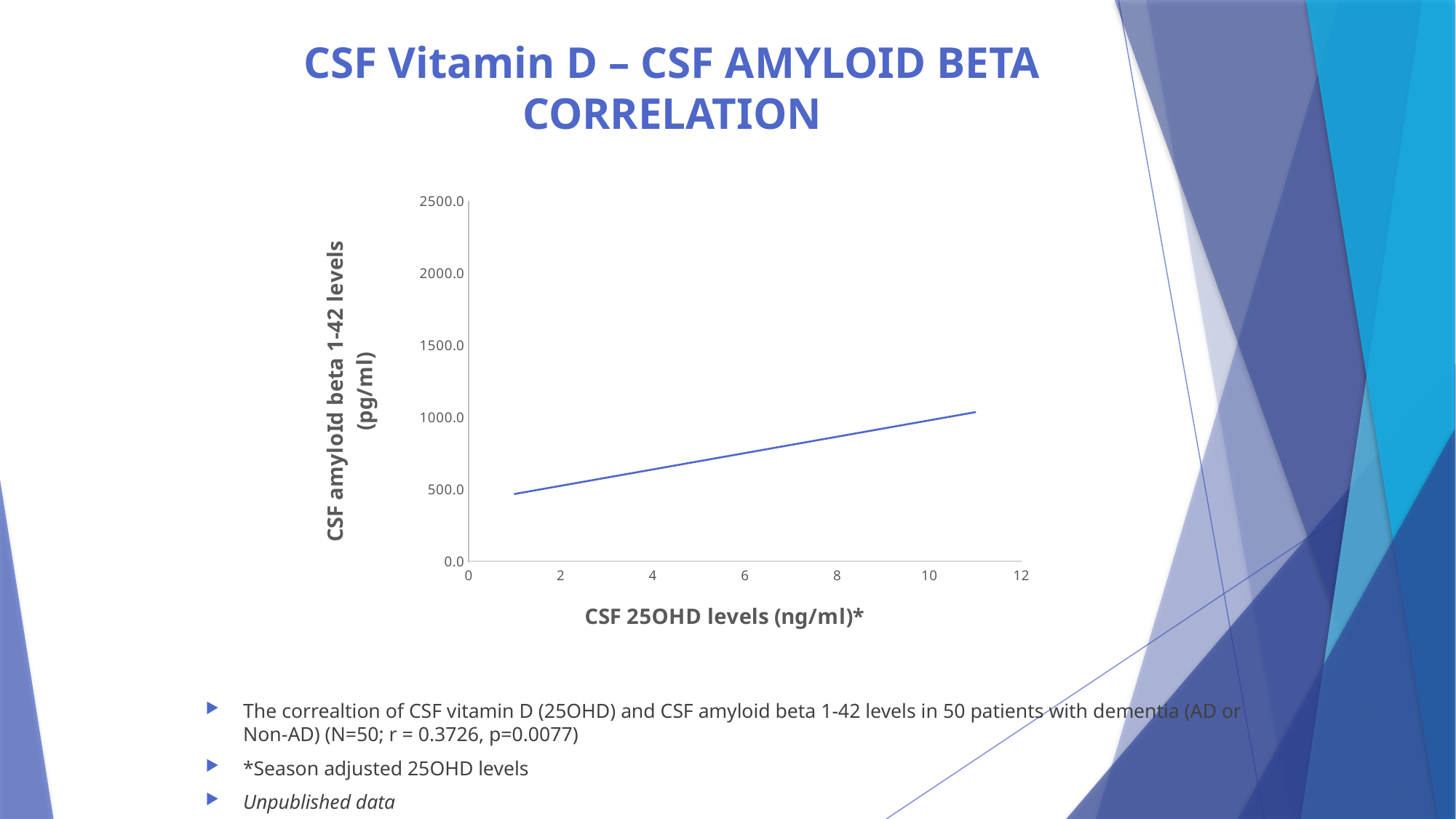
Do the CSF amyloid beta 1-42 levels rise or fall as CSF 25OHD levels increase along the x axis? rise Is the CSF amyloid beta 1-42 value at a CSF 25OHD level of 6 ng/ml greater or less than 1000.0? less Is the CSF amyloid beta 1-42 value at a CSF 25OHD level of 10 ng/ml greater or less than 500.0? greater Is the value of the line at the right end (CSF 25OHD level of 11 ng/ml) larger or smaller than at the left end (1 ng/ml)? larger What kind of chart is shown on the slide? line chart What is the label of the x axis of the chart? CSF 25OHD levels (ng/ml)* Is the CSF amyloid beta 1-42 value at a CSF 25OHD level of 8 ng/ml greater or less than 1500.0? less What is the label of the y axis of the chart? CSF amyloId beta 1-42 levels (pg/ml) What is the maximum value shown on the y axis of the chart? 2500.0